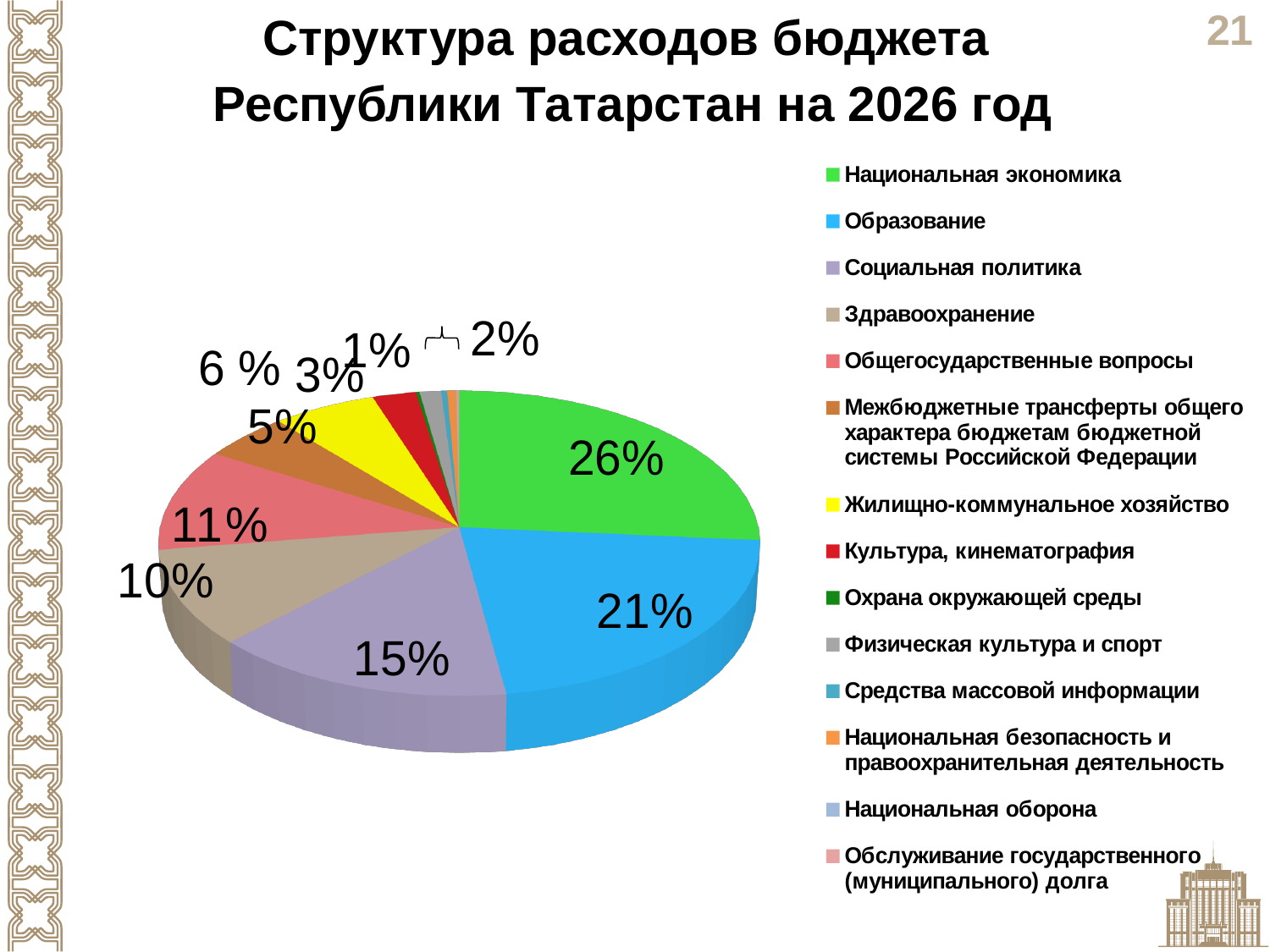
Which category has the largest share of the pie? Национальная экономика What is the title of the chart on the slide? Структура расходов бюджета Республики Татарстан на 2026 год What share of the pie does Национальная экономика have? 26% What is the difference in percentage points between the shares of Национальная экономика and Образование? 5 What share of the pie does Общегосударственные вопросы have? 11% Which has the larger share, Образование or Социальная политика? Образование How many categories does the legend list? 14 What share of the pie does Образование have? 21% What kind of chart is shown on the slide? pie chart